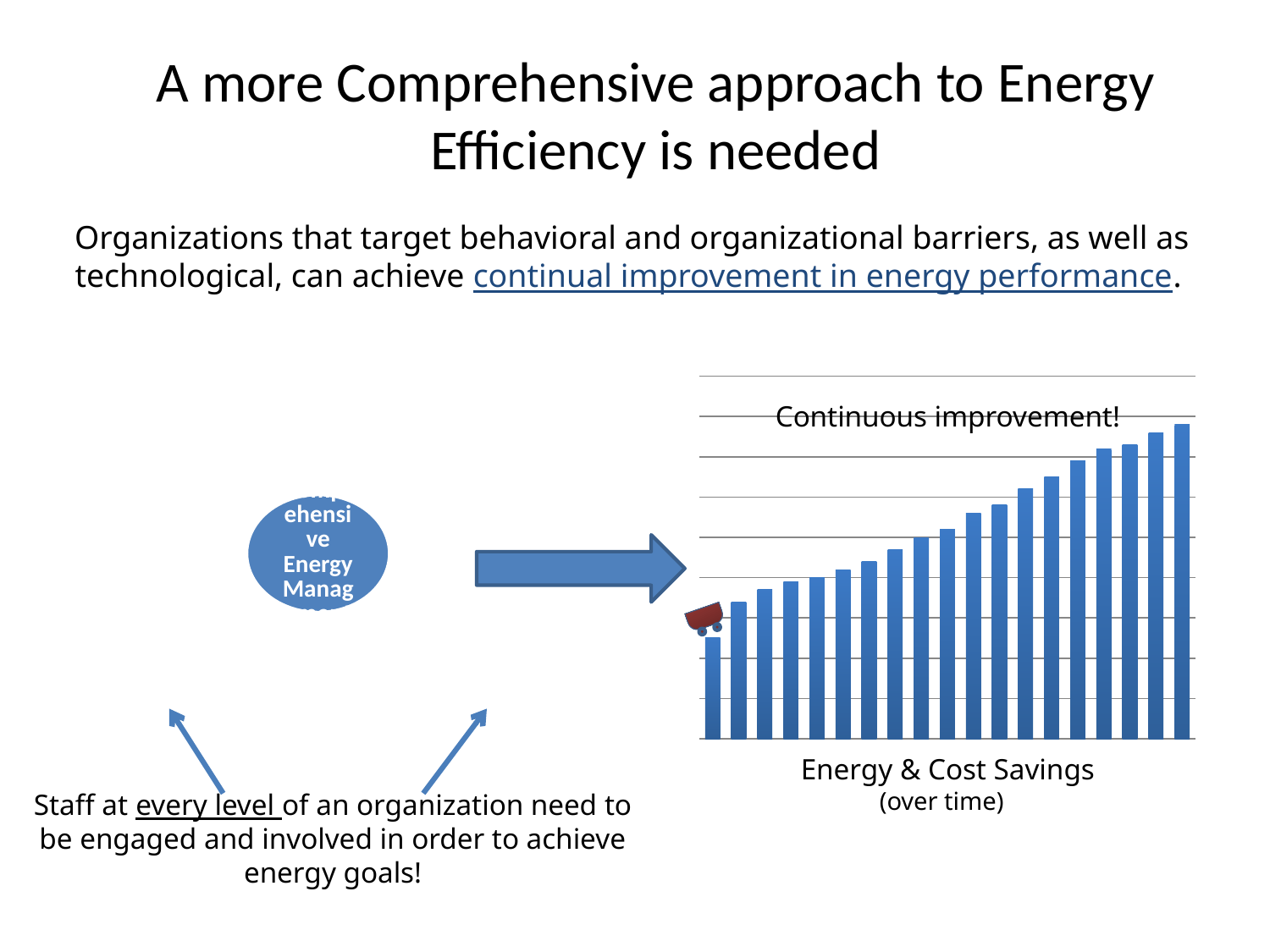
What kind of chart is shown on the right side of the slide? bar chart Do the bar values rise or fall from left to right along the x axis of the chart? rise Which bar in the chart is the shortest, the leftmost or the rightmost? the leftmost Which bar in the chart is the tallest, the leftmost or the rightmost? the rightmost What text is written inside the chart area above the bars? Continuous improvement! Is the rightmost bar in the chart taller or shorter than the leftmost bar? taller What caption appears below the chart? Energy & Cost Savings (over time)